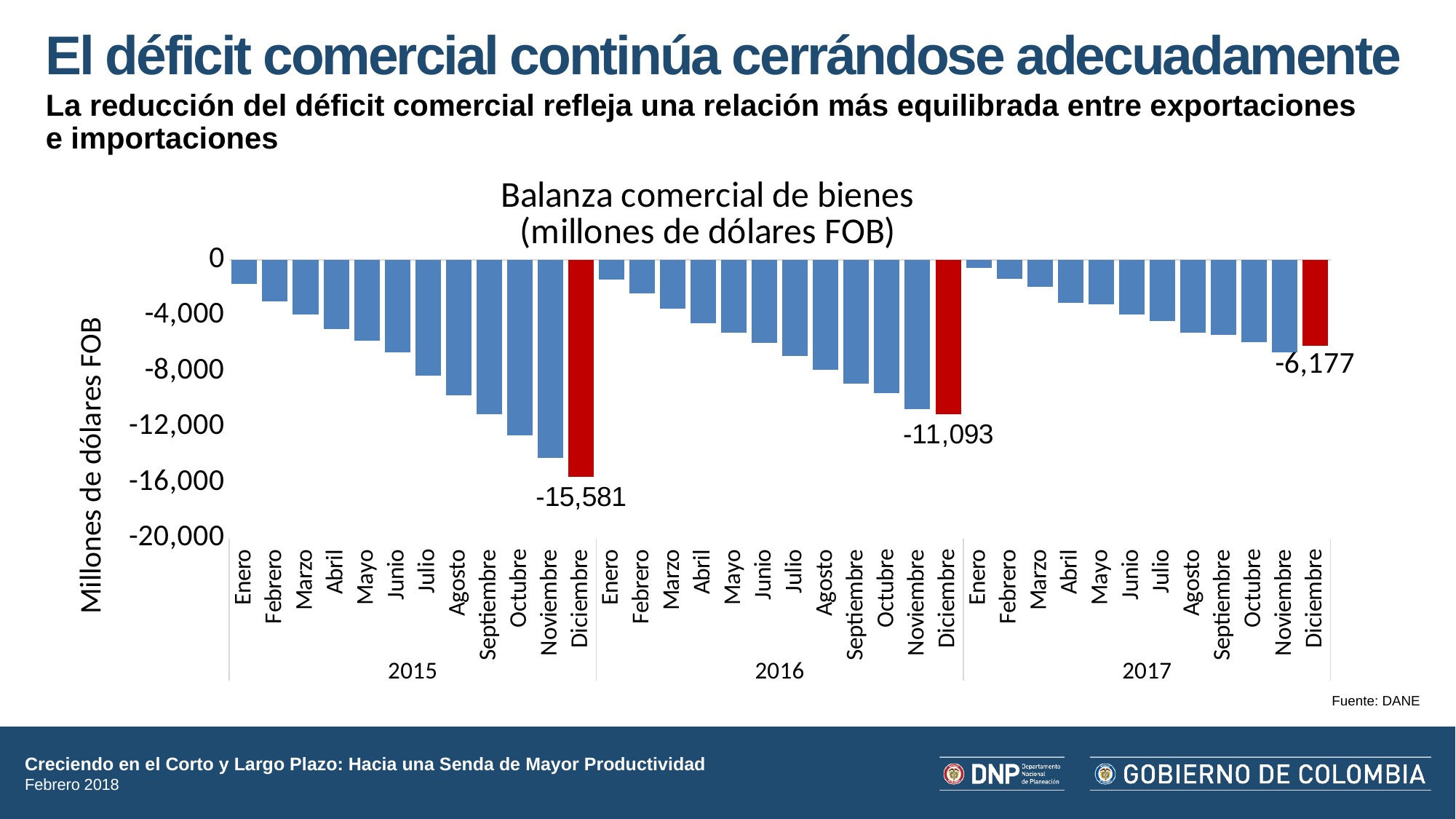
By how much did the labelled December value change between Diciembre 2015 (-15,581) and Diciembre 2016 (-11,093)? 4,488 Is the value for Noviembre 2017 greater or less than -8,000? greater What is the difference between the Diciembre 2016 value (-11,093) and the Diciembre 2017 value (-6,177)? 4,916 Is the value for Diciembre 2017 larger (less negative) than the value for Diciembre 2016? Yes, Diciembre 2017 (-6,177) Which of the three labelled December values is the most negative? Diciembre 2015 (-15,581) Is the value for Noviembre 2015 greater or less than -12,000? less What is the value for Diciembre 2015 in the Balanza comercial de bienes chart? -15,581 What kind of chart is shown on the slide? Bar chart Within each year, do the values rise or fall from Enero to Diciembre? Fall (become more negative) What is the value for Diciembre 2016 in the Balanza comercial de bienes chart? -11,093 What is the value for Diciembre 2017 in the Balanza comercial de bienes chart? -6,177 How many monthly bars are plotted in the chart in total? 36